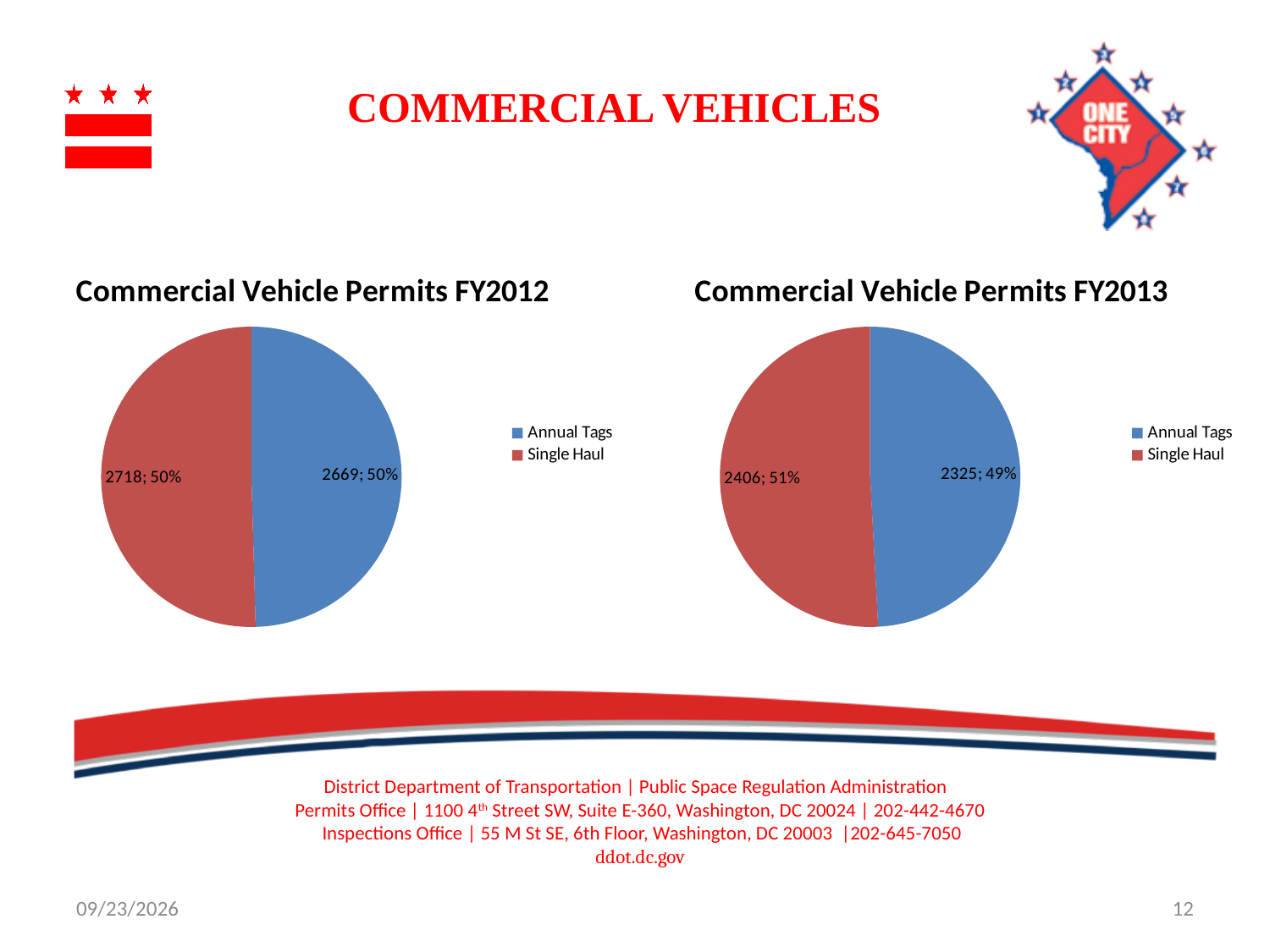
In the Commercial Vehicle Permits FY2013 chart, how many Single Haul permits are shown? 2406 In the Commercial Vehicle Permits FY2013 chart, which category has the larger value, Annual Tags or Single Haul? Single Haul In the Commercial Vehicle Permits FY2013 chart, what share of the pie is Annual Tags? 49% In the Commercial Vehicle Permits FY2012 chart, what is the difference between the Single Haul and Annual Tags values? 49 In the Commercial Vehicle Permits FY2012 chart, what share of the pie is Annual Tags? 50% In the Commercial Vehicle Permits FY2013 chart, how many Annual Tags permits are shown? 2325 In the Commercial Vehicle Permits FY2013 chart, what share of the pie is Single Haul? 51% In the Commercial Vehicle Permits FY2013 chart, what is the total of the two slices? 4731 How many categories does the legend of the Commercial Vehicle Permits FY2013 chart list? 2 In the Commercial Vehicle Permits FY2012 chart, how many Single Haul permits are shown? 2718 In the Commercial Vehicle Permits FY2012 chart, how many Annual Tags permits are shown? 2669 What type of chart is the Commercial Vehicle Permits FY2012 chart? Pie chart